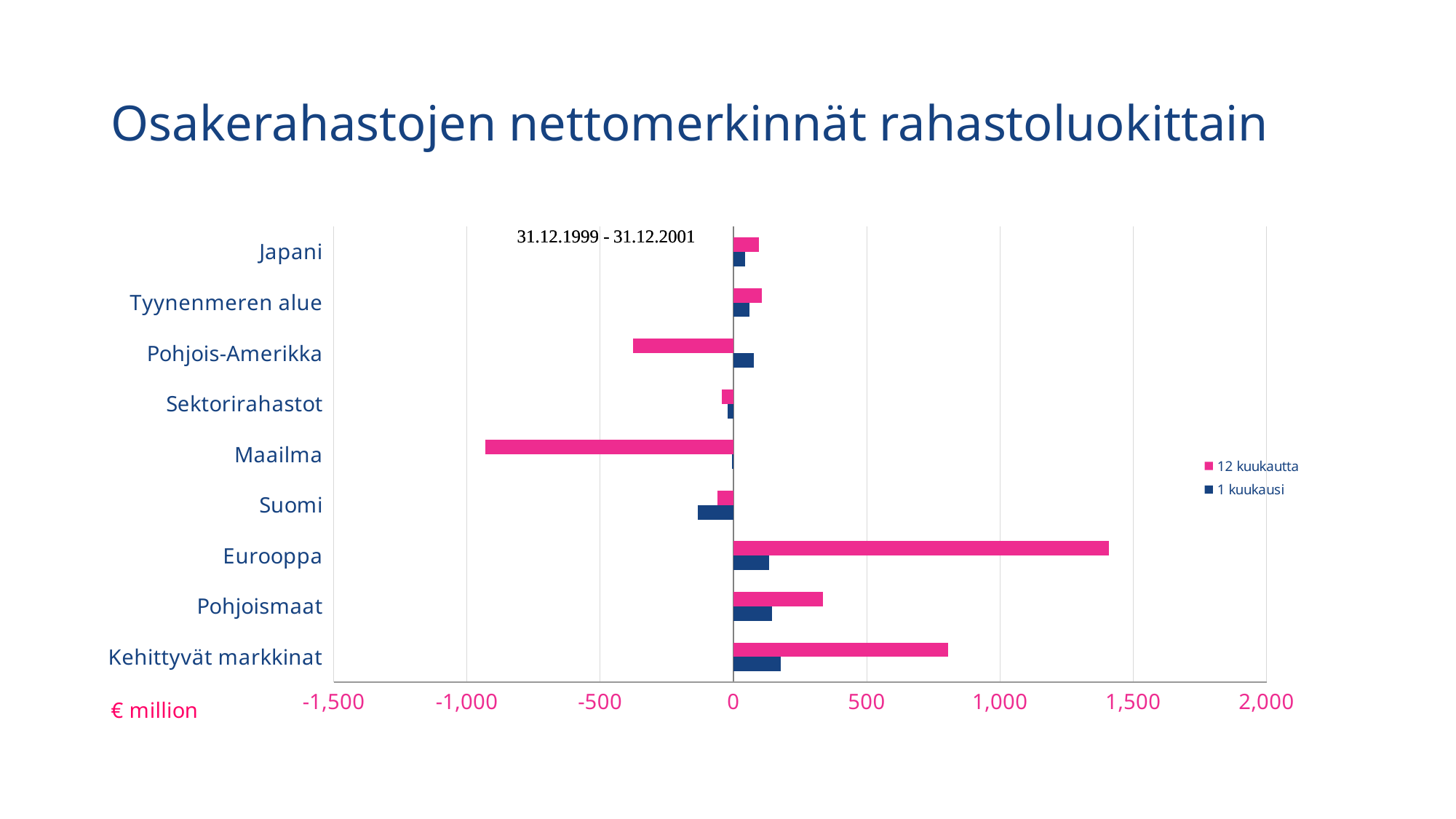
How many series does the legend list? 2 Is the 12 kuukautta value for Kehittyvät markkinat greater or less than 500? greater Which category has the highest 12 kuukautta value? Eurooppa Is the 12 kuukautta value for Eurooppa greater or less than 1,000? greater Which category has the lowest 1 kuukausi value? Suomi Which category has the lowest 12 kuukautta value? Maailma What unit is shown for the x axis of the chart? € million Which is larger for the 12 kuukautta series: Kehittyvät markkinat or Pohjoismaat? Kehittyvät markkinat What is the title of the chart on the slide? Osakerahastojen nettomerkinnät rahastoluokittain How many fund categories are plotted on the chart? 9 What kind of chart is shown on the slide? bar chart Is the 12 kuukautta value for Maailma greater or less than -500? less